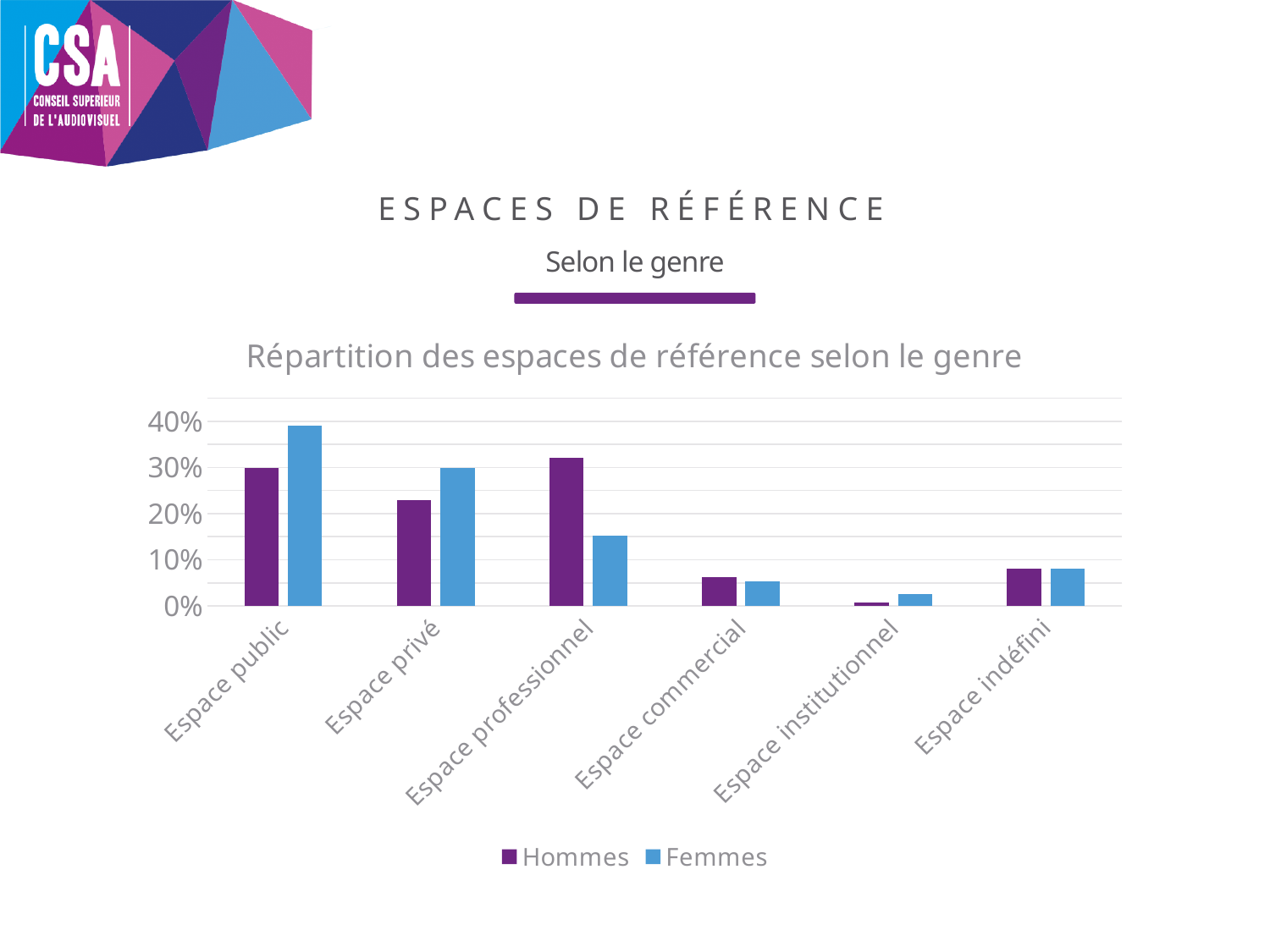
For Espace professionnel, which series has the larger value, Hommes or Femmes? Hommes Which category has the highest value for Femmes? Espace public Which category has the lowest value for Hommes? Espace institutionnel What kind of chart is shown on the slide? bar chart Which category has the highest value for Hommes? Espace professionnel How many categories are shown on the x axis? 6 Is the value for Femmes in Espace public greater or less than 30%? greater What is the title of the chart? Répartition des espaces de référence selon le genre Which category has the lowest value for Femmes? Espace institutionnel Is the value for Hommes in Espace privé greater or less than 30%? less Is the value for Femmes in Espace professionnel greater or less than 20%? less How many series does the legend list? 2